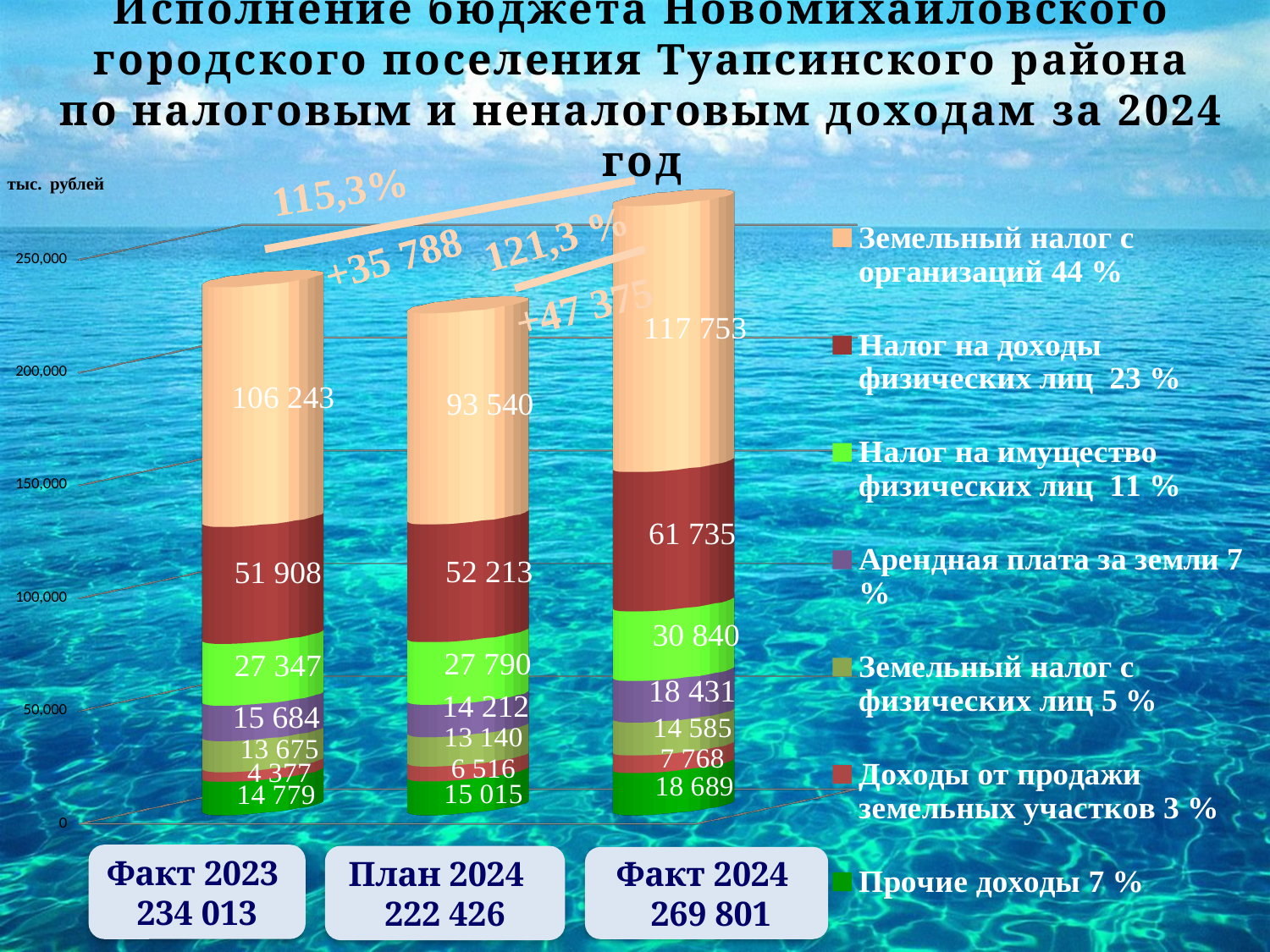
What unit is indicated at the top left of the chart? тыс. рублей How many series does the legend list? 7 What is the value of Налог на доходы физических лиц for План 2024? 52 213 What type of chart is shown on the slide? stacked bar chart What is the value of Доходы от продажи земельных участков for Факт 2023? 4 377 What is the value of Земельный налог с организаций for Факт 2024? 117 753 What is the difference between Земельный налог с организаций for Факт 2024 and Факт 2023? 11 510 Which category has the lowest total? План 2024 How many bars (categories) are plotted on the chart? 3 What is the total of the Факт 2024 stacked bar? 269 801 Which category has the highest total? Факт 2024 Which is larger: Прочие доходы for Факт 2023 or for План 2024? План 2024